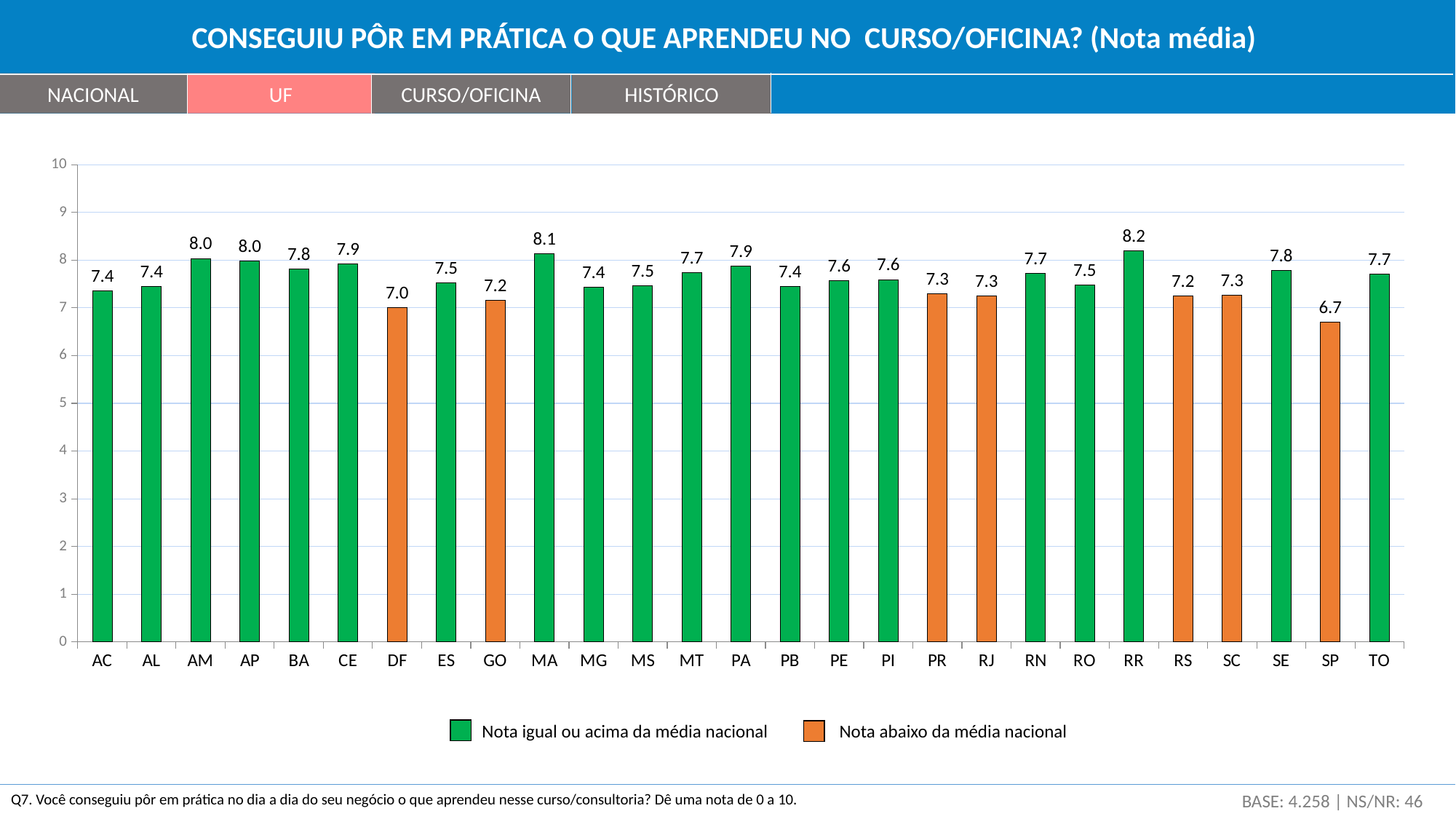
What is the value for MA? 8.1 How many entries does the legend list? 2 Which is larger, the value for CE or the value for GO? CE How many bars are coloured orange (Nota abaixo da média nacional)? 7 What is the value for SP? 6.7 Is the value for AM greater or less than 7? greater Which UF has the highest value? RR What is the difference between the values for RR and SP? 1.5 Which UF has the lowest value? SP What kind of chart is shown on the slide? bar chart What is the value for DF? 7.0 How many UFs are shown on the x axis? 27